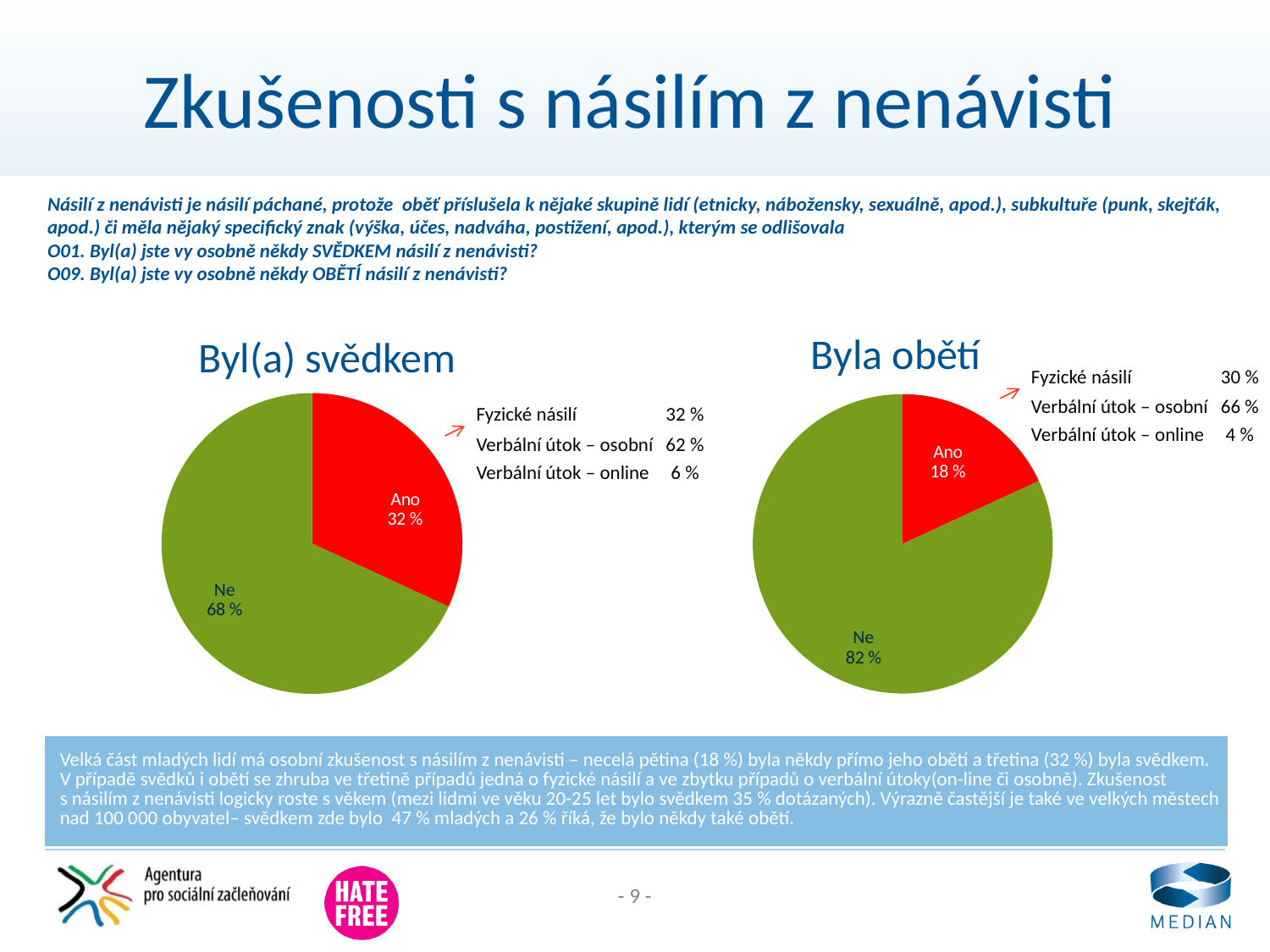
In the 'Byla obětí' chart, what is the value for 'Ne'? 82 % In the 'Byl(a) svědkem' chart, what is the difference between 'Ne' and 'Ano'? 36 % Which is larger: 'Ano' in the 'Byl(a) svědkem' chart or 'Ano' in the 'Byla obětí' chart? 'Ano' in the 'Byl(a) svědkem' chart What kind of chart is the 'Byla obětí' chart? Pie chart In the 'Byl(a) svědkem' chart, what is the value for 'Ano'? 32 % How many slices does the 'Byl(a) svědkem' chart have? 2 In the 'Byla obětí' chart, what is the value for 'Ano'? 18 % In the 'Byla obětí' chart, what is the difference between 'Ne' and 'Ano'? 64 % In the 'Byla obětí' chart, which slice is the smallest? Ano In the 'Byl(a) svědkem' chart, what is the value for 'Ne'? 68 % In the 'Byl(a) svědkem' chart, what colour is the 'Ano' slice? Red In the 'Byl(a) svědkem' chart, which slice is the largest? Ne